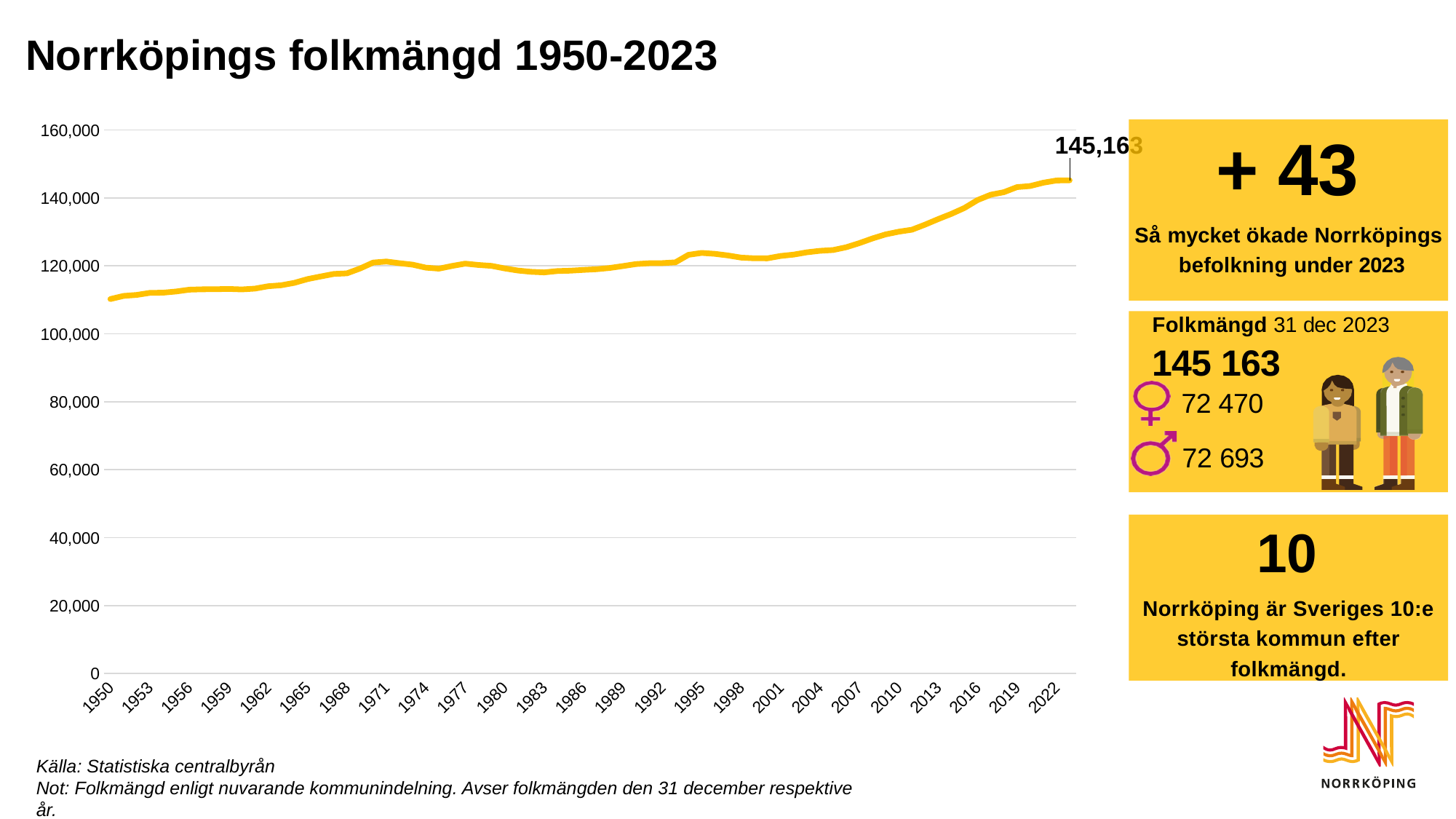
Which year has the highest population on the chart? 2023 Is the population value for 1965 greater or less than 120,000? less Is the population value for 2022 greater or less than 140,000? greater What is the title of the chart? Norrköpings folkmängd 1950-2023 Is the population value for 1950 greater or less than 100,000? greater What is the population value labelled at the end of the line for 2023? 145,163 What kind of chart is shown on the slide? Line chart Which year has the lowest population on the chart? 1950 What colour is the line plotted on the chart? Yellow Does the population line generally rise or fall from 1950 to 2023? Rise